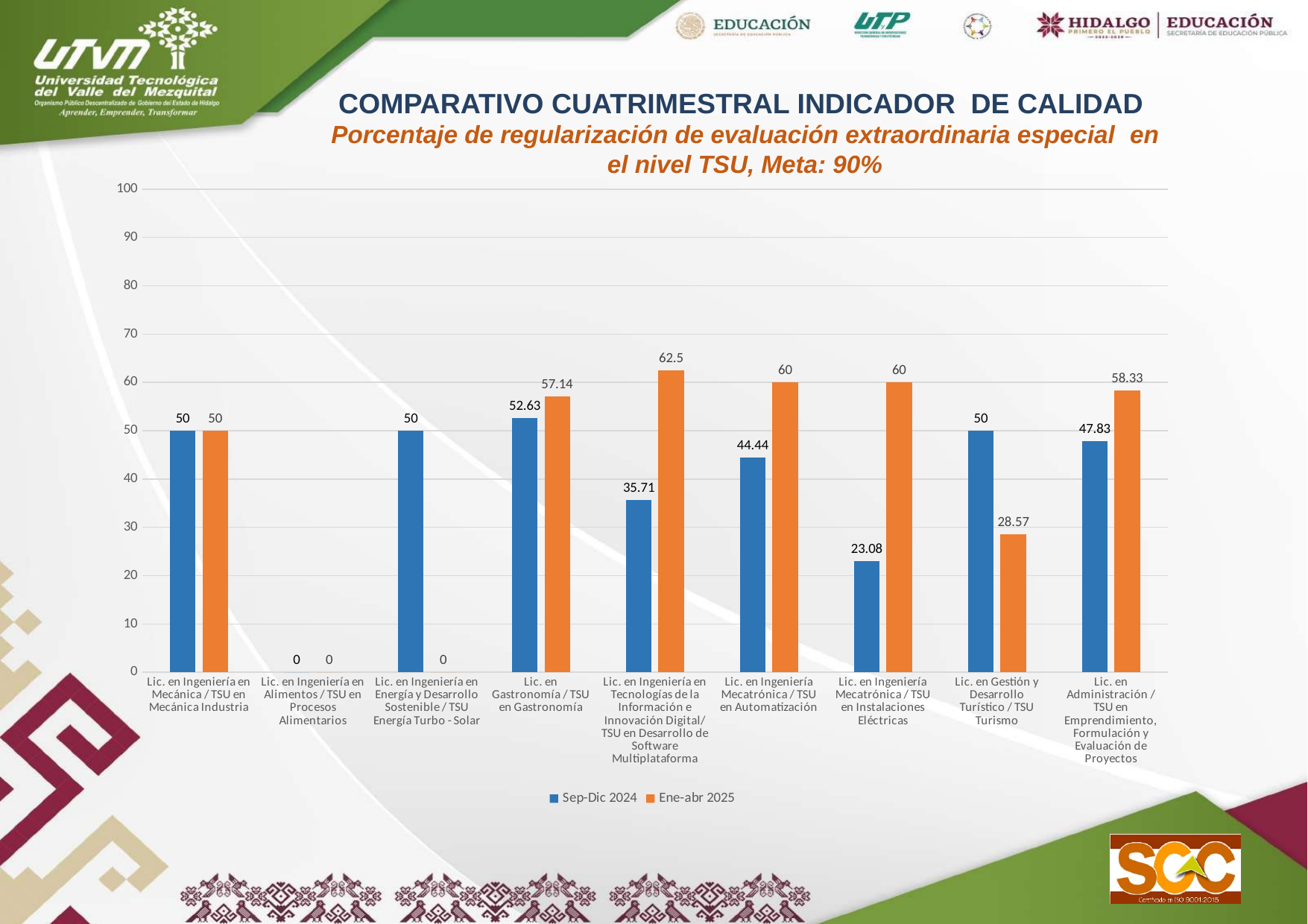
What is the Ene-abr 2025 value for Lic. en Gastronomía / TSU en Gastronomía? 57.14 For Lic. en Gestión y Desarrollo Turístico / TSU Turismo, which series has the larger value, Sep-Dic 2024 or Ene-abr 2025? Sep-Dic 2024 Which category has the highest Sep-Dic 2024 value? Lic. en Gastronomía / TSU en Gastronomía Which category has the highest Ene-abr 2025 value? Lic. en Ingeniería en Tecnologías de la Información e Innovación Digital/ TSU en Desarrollo de Software Multiplataforma What is the Ene-abr 2025 value for Lic. en Gestión y Desarrollo Turístico / TSU Turismo? 28.57 How many categories are shown on the x axis? 9 Is the Ene-abr 2025 value for Lic. en Administración / TSU en Emprendimiento, Formulación y Evaluación de Proyectos greater or less than 50? greater What is the Sep-Dic 2024 value for Lic. en Ingeniería Mecatrónica / TSU en Instalaciones Eléctricas? 23.08 What is the difference between the Ene-abr 2025 and Sep-Dic 2024 values for Lic. en Ingeniería Mecatrónica / TSU en Instalaciones Eléctricas? 36.92 How many series does the legend list? 2 What kind of chart is shown on the slide? bar chart Which category has the lowest Sep-Dic 2024 value? Lic. en Ingeniería en Alimentos / TSU en Procesos Alimentarios